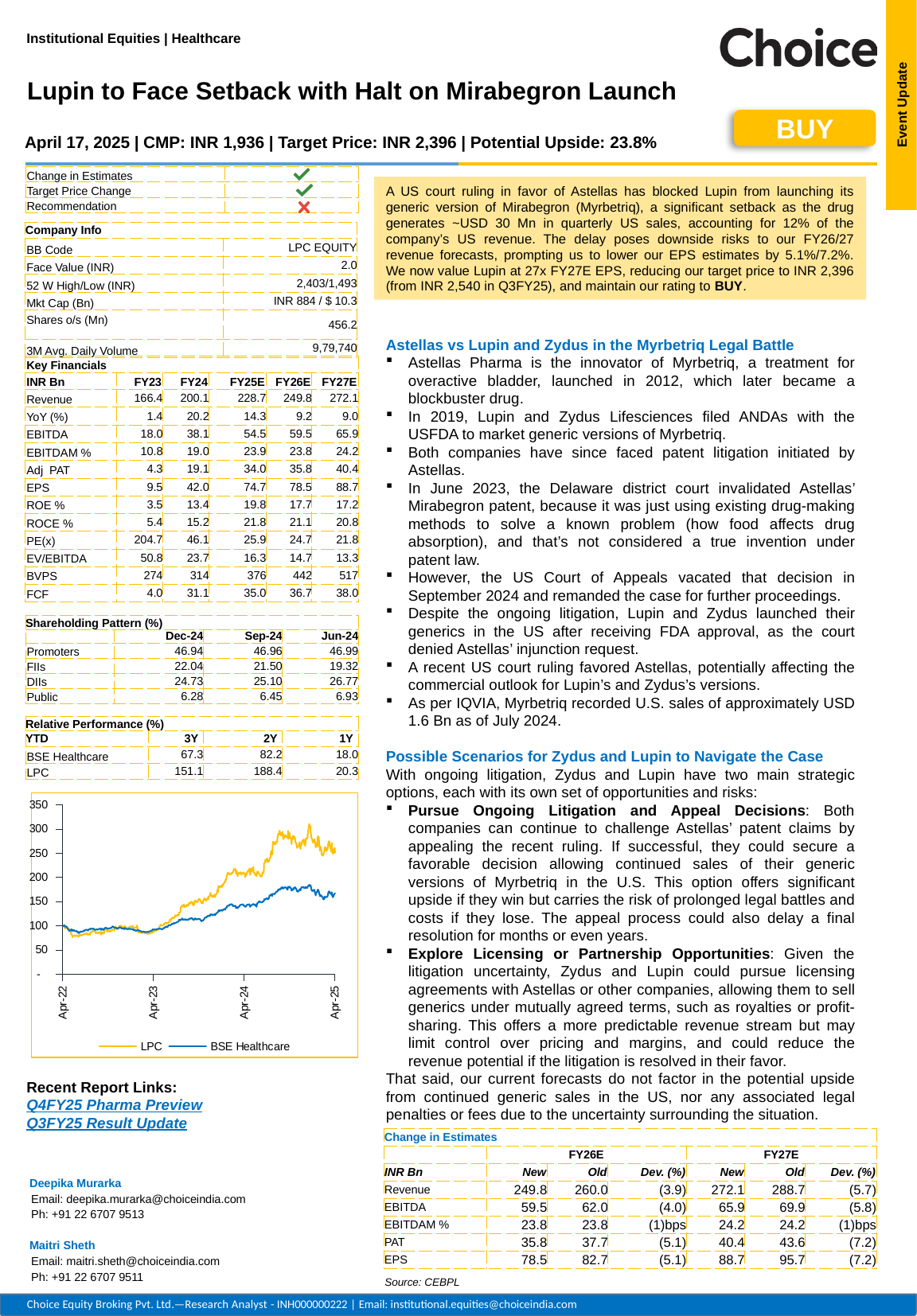
What is the highest tick value shown on the y axis of the line chart? 350 What kind of chart is shown at the bottom left of the slide? line chart How many date labels are shown on the x axis of the line chart? 4 In the line chart, is the value for BSE Healthcare at Apr-25 greater or less than 200? less In the line chart, which series is higher at Apr-25, LPC or BSE Healthcare? LPC In the line chart, is the peak value of the LPC series greater or less than 250? greater In the line chart, which colour is used for the LPC series? yellow In the line chart, is the value for LPC at Apr-25 greater or less than 200? greater What are the two series named in the legend of the line chart? LPC and BSE Healthcare How many series does the legend of the line chart list? 2 In the line chart, does the LPC series overall rise or fall from Apr-22 to Apr-25? rise